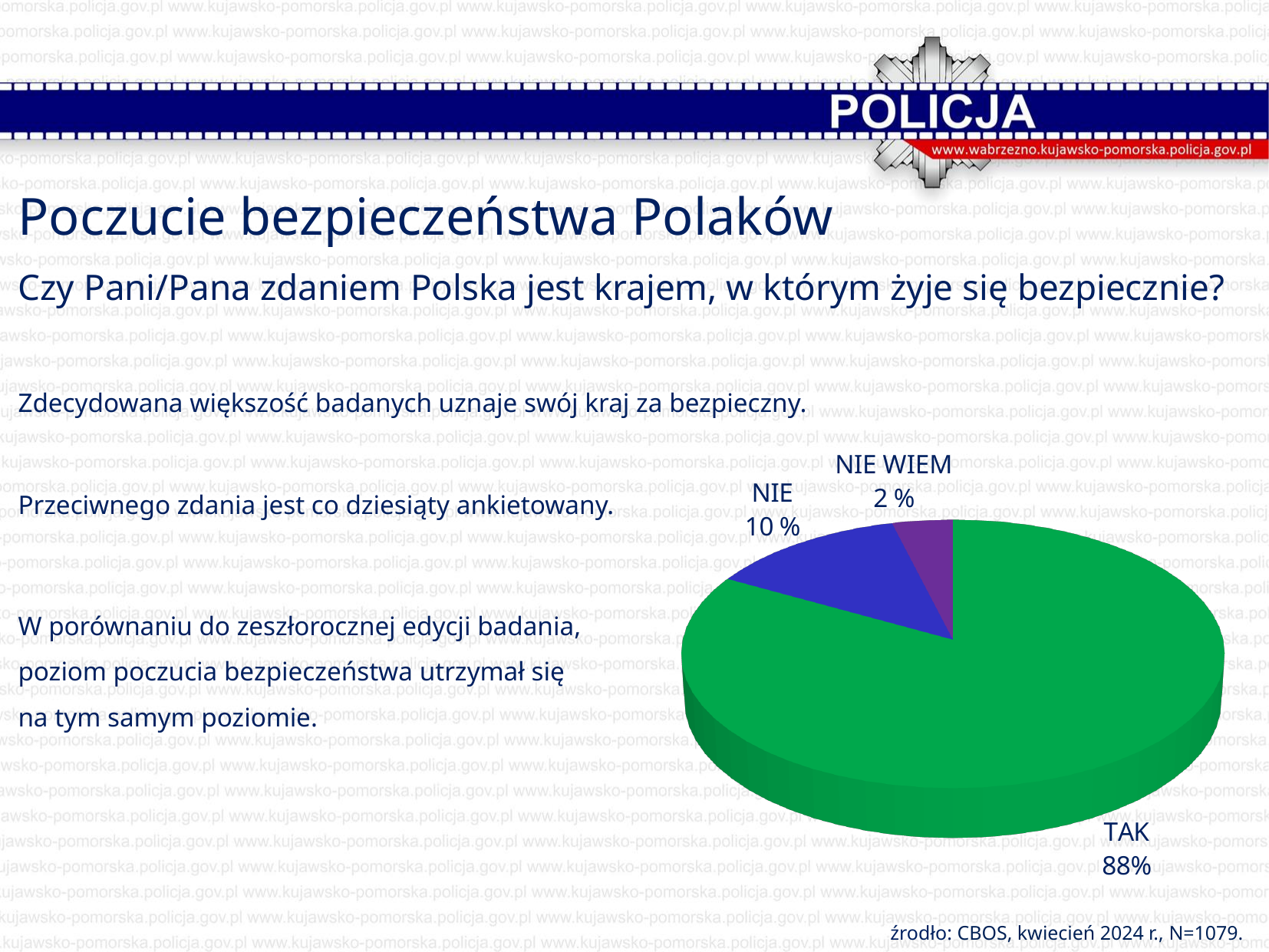
Which slice of the pie chart is the smallest? NIE WIEM What is the difference between the NIE and NIE WIEM values in the pie chart? 8 percentage points What is the value for NIE WIEM in the pie chart? 2 % What is the value for TAK in the pie chart? 88% How many slices does the pie chart have? 3 What is the value for NIE in the pie chart? 10 % What is the difference between the TAK and NIE values in the pie chart? 78 percentage points Which slice of the pie chart is the largest? TAK Which is larger in the pie chart, NIE or NIE WIEM? NIE What colour is the NIE slice in the pie chart? blue What colour is the TAK slice in the pie chart? green What kind of chart is shown on the slide? pie chart